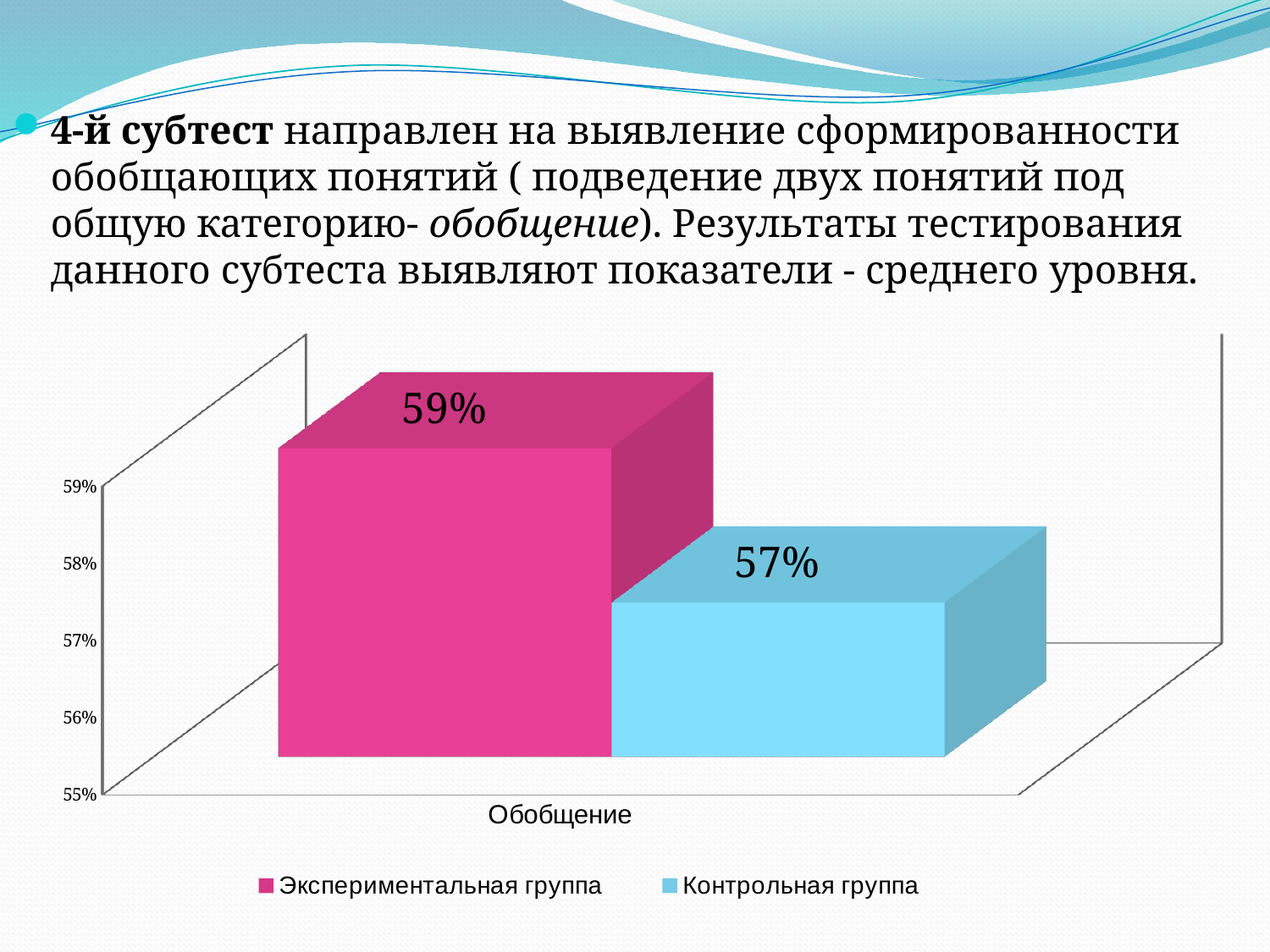
What is the value for Экспериментальная группа in the Обобщение category? 59% What colour is the bar for Контрольная группа? light blue Which series has the higher value for Обобщение? Экспериментальная группа Is the value for Экспериментальная группа larger or smaller than the value for Контрольная группа? larger What is the category label on the x axis? Обобщение How many categories are shown on the x axis? 1 What kind of chart is shown on the slide? bar chart Which series has the lower value for Обобщение? Контрольная группа How many series does the legend list? 2 What is the difference between the Экспериментальная группа and Контрольная группа values? 2% What is the value for Контрольная группа in the Обобщение category? 57%